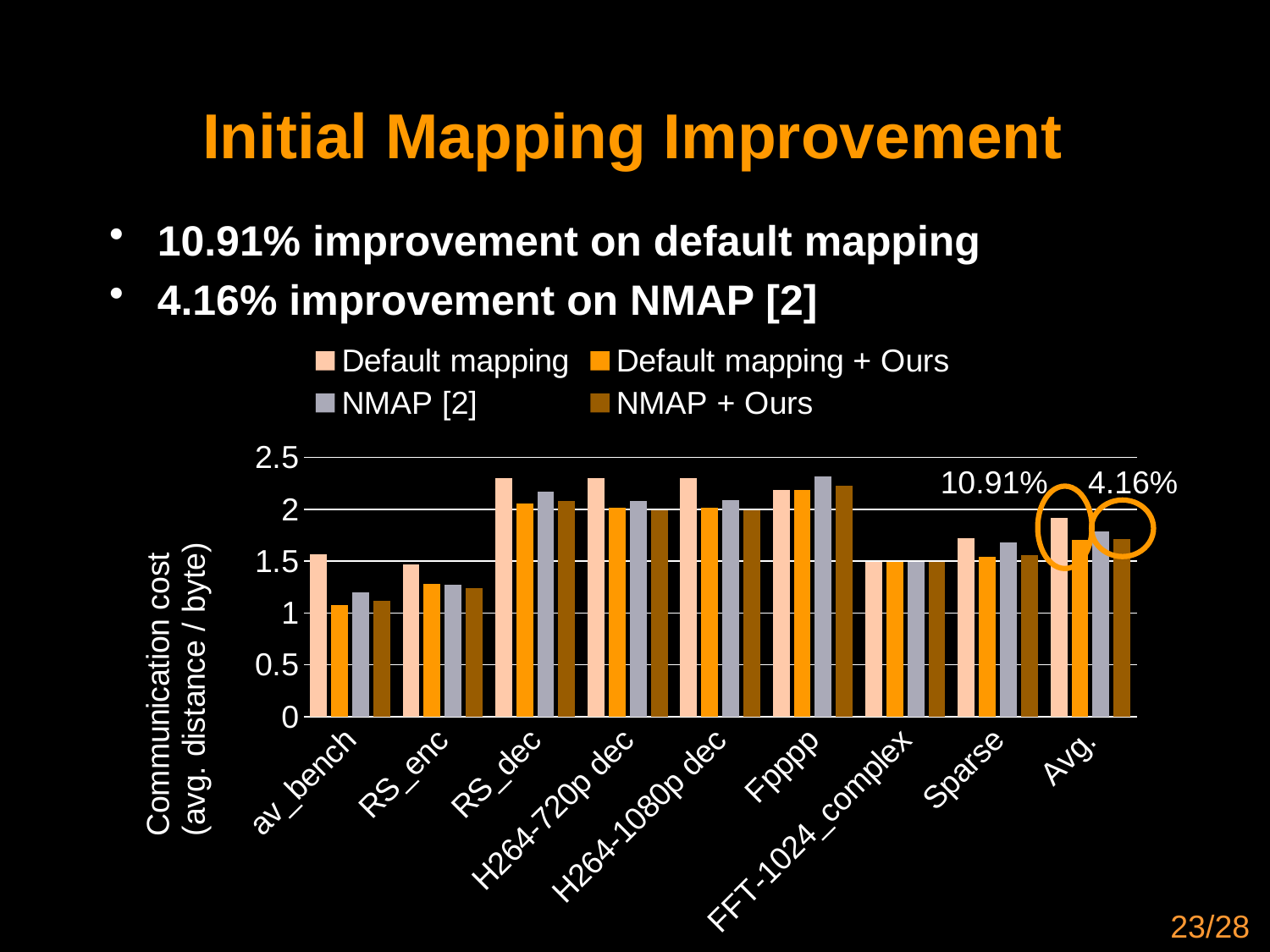
Is the Default mapping value for Avg. greater or less than 2? less What is the y-axis label of the chart? Communication cost (avg. distance / byte) Is the Default mapping value for RS_dec greater or less than 2? greater What percentage improvement is annotated above the Default mapping bar for Avg.? 10.91% How many series does the legend list? 4 Is the Default mapping value for Sparse greater or less than 1.5? greater Which category has the lowest NMAP + Ours value? av_bench For RS_enc, which is larger: Default mapping or NMAP [2]? Default mapping How many categories are shown along the x axis? 9 What kind of chart is shown on the slide? bar chart For av_bench, which series has the highest value? Default mapping